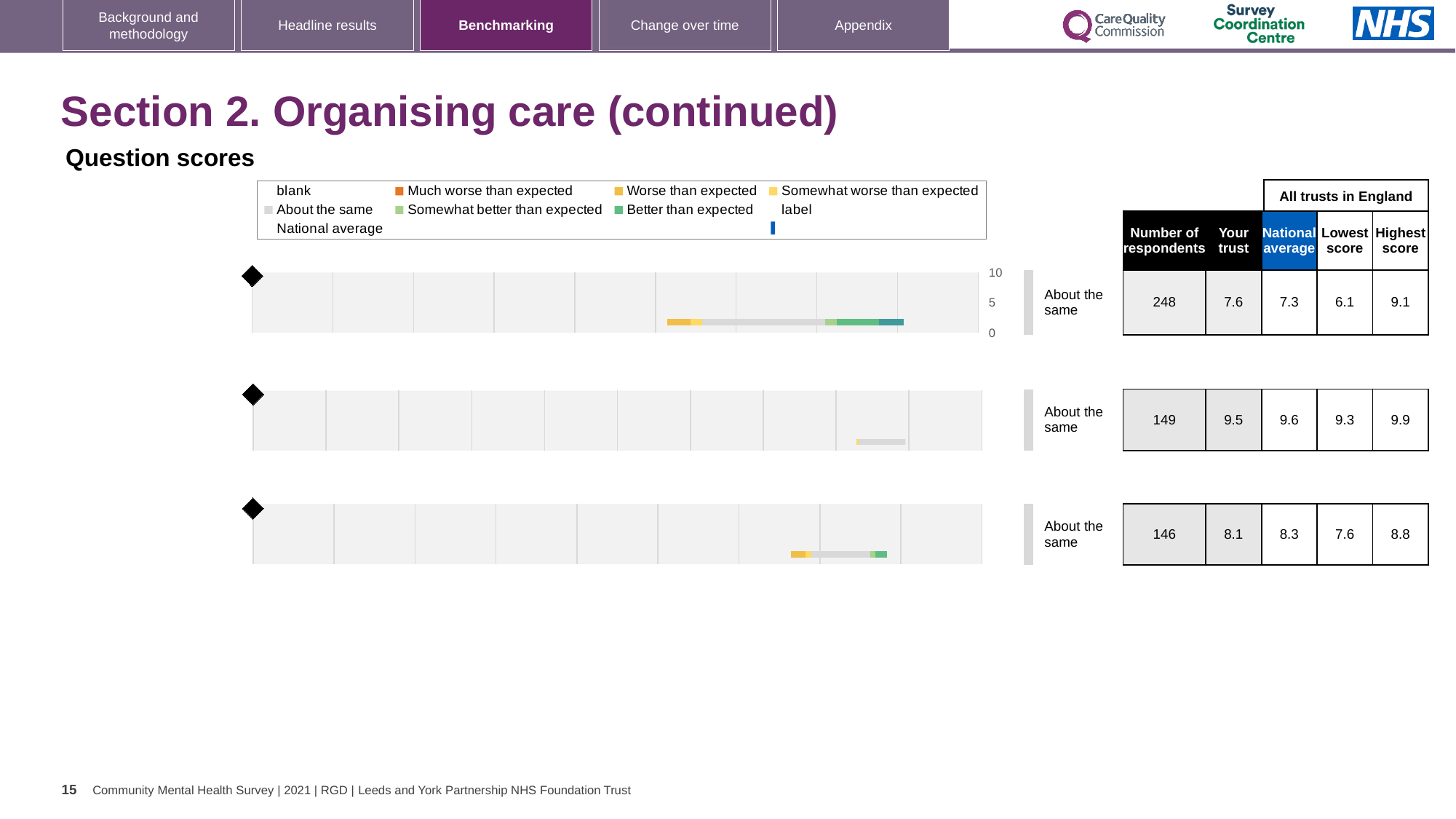
For the middle chart, which is larger: the 'Your trust' score or the national average? National average For the bottom chart, what is the highest score across all trusts in England? 8.8 What kind of chart is used for the three benchmarking charts on the slide? bar chart Which chart (top, middle or bottom) has the highest 'Your trust' score? middle What benchmark category label is shown next to each of the three charts? About the same How many benchmarking charts are shown on the slide? 3 What is the highest tick value shown on the vertical axis of the top chart? 10 For the top chart, what is the national average score shown in the table? 7.3 For the middle chart, how many respondents are shown in the table? 149 For the top chart, what is the difference between the highest score and the lowest score across all trusts in England? 3.0 For the bottom chart, what is the lowest score across all trusts in England? 7.6 For the top chart, what is the 'Your trust' score shown in the table? 7.6